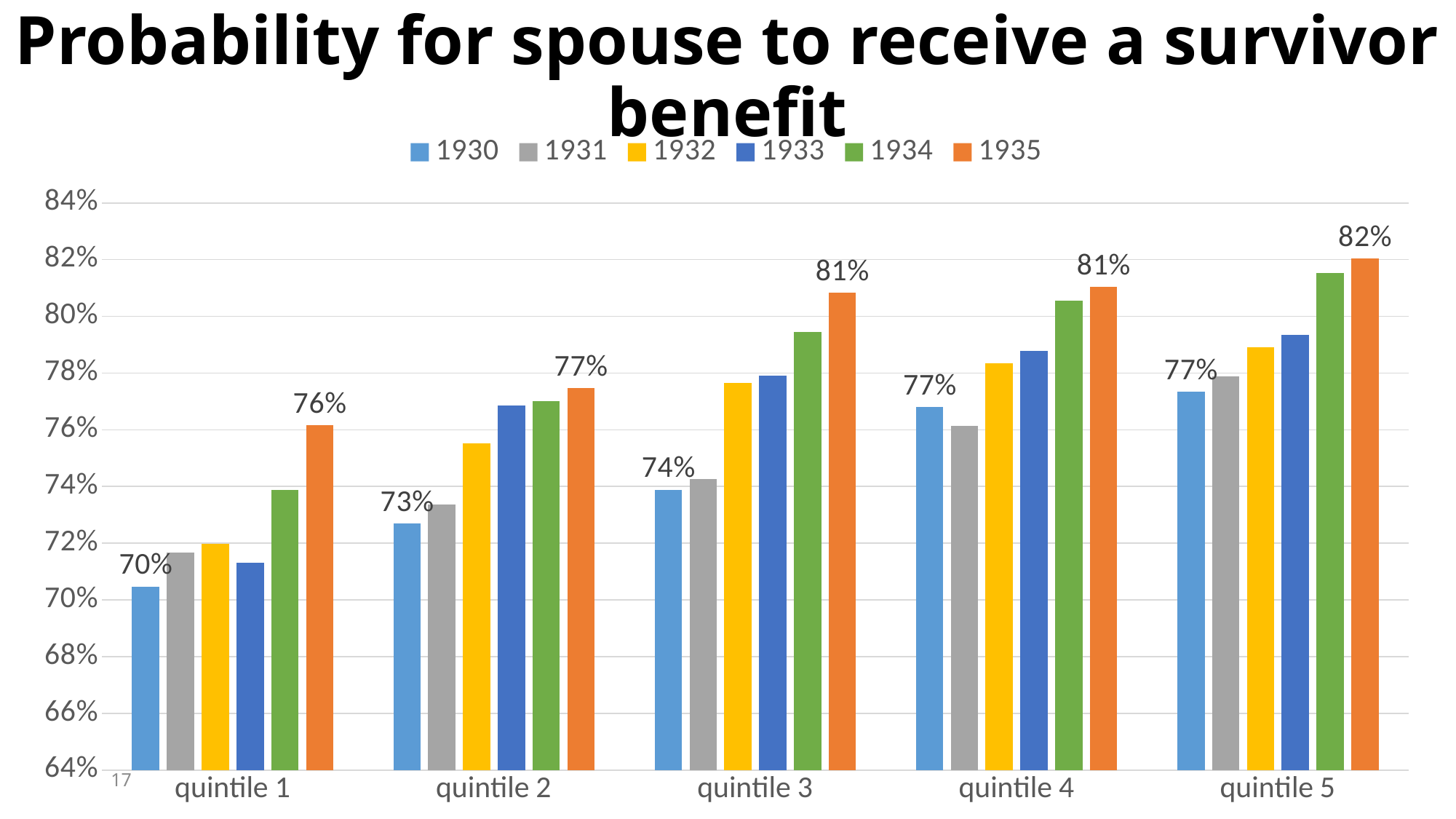
How many quintile categories are shown on the x axis? 5 What is the value for 1935 in quintile 5? 82% Which quintile has the highest value for the 1935 series? quintile 5 Which is larger in quintile 2: the 1930 value or the 1935 value? 1935 Which quintile has the lowest value for the 1930 series? quintile 1 What is the value for 1935 in quintile 3? 81% How many series does the legend list? 6 What is the difference between the 1935 and 1930 values in quintile 3? 7% What is the value for 1930 in quintile 1? 70% What kind of chart is shown on the slide? bar chart What is the value for 1930 in quintile 4? 77% Is the value for 1934 in quintile 1 greater or less than 76%? less